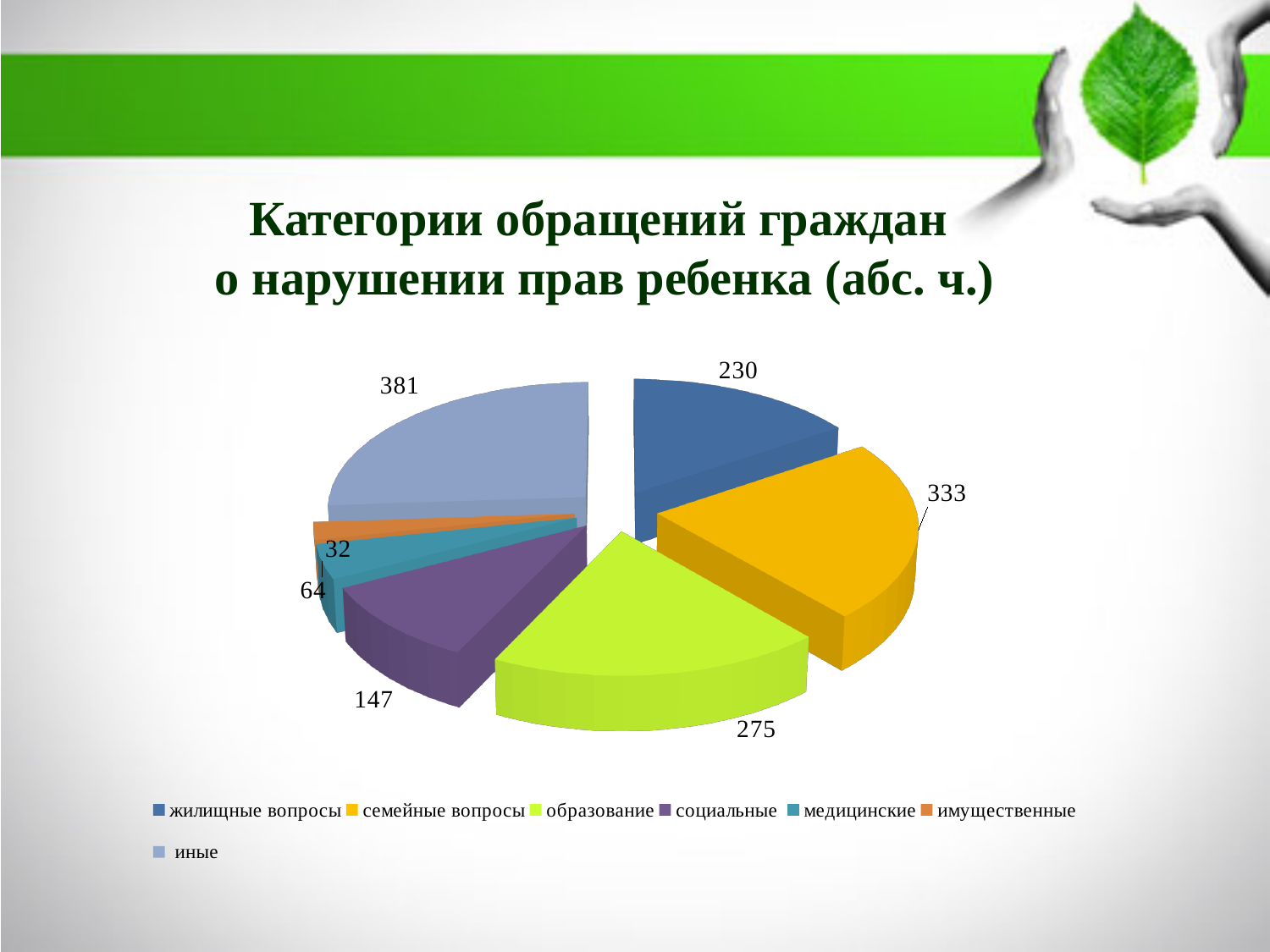
What is the value for the category "медицинские"? 64 Which category has the highest value? иные Which category has the lowest value? имущественные What kind of chart is shown on the slide? pie chart What is the value for the category "иные"? 381 What is the difference between the values for "семейные вопросы" and "жилищные вопросы"? 103 What is the title of the chart? Категории обращений граждан о нарушении прав ребенка (абс. ч.) What is the value for "семейные вопросы"? 333 What is the total of all the values shown in the pie chart? 1462 Which is larger, the value for "образование" or for "социальные"? образование How many categories does the pie chart have? 7 What is the value for "жилищные вопросы"? 230